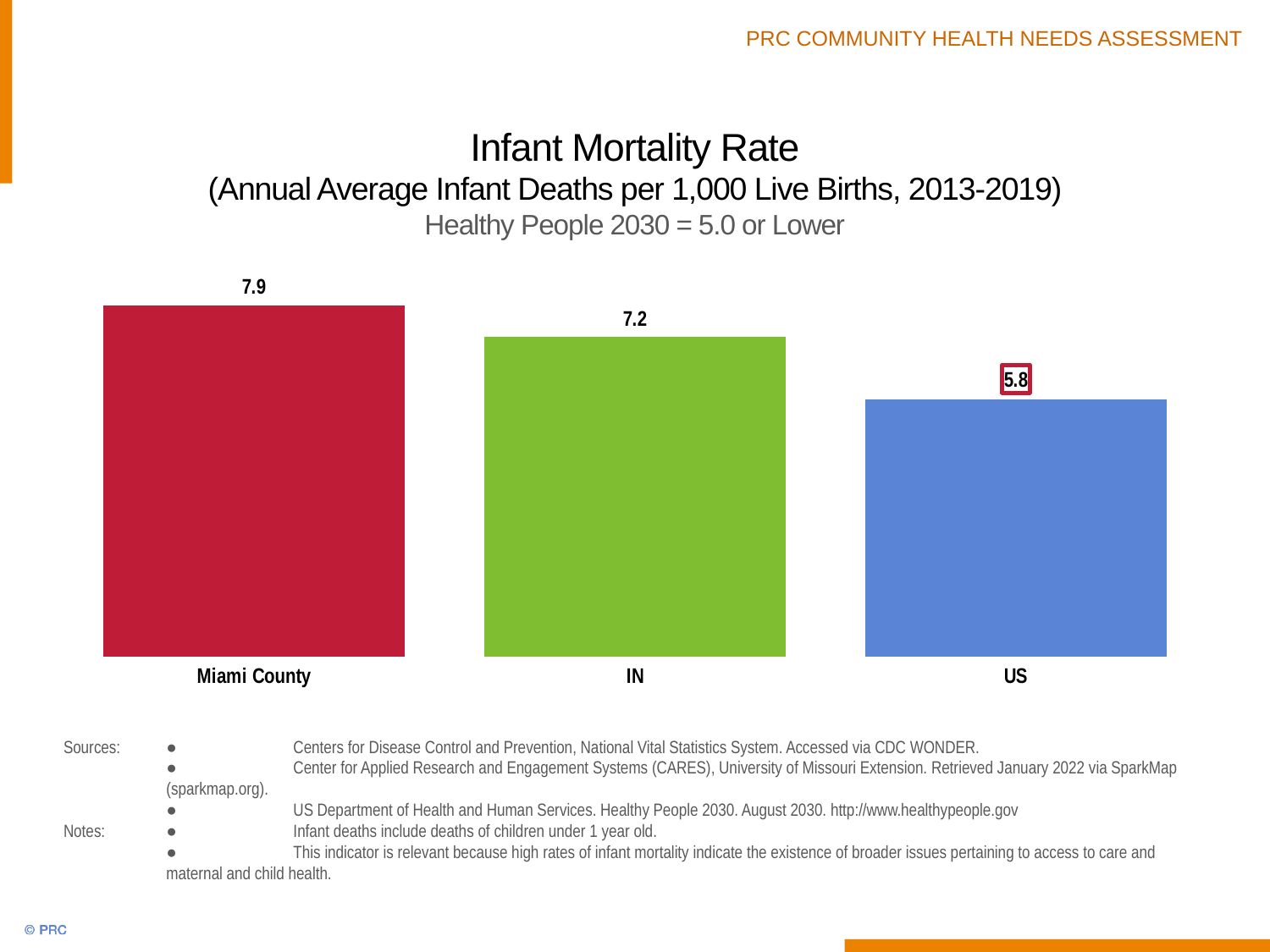
How many categories are shown in the chart? 3 What is the difference between the infant mortality rates for Miami County and IN? 0.7 Which category has the highest infant mortality rate? Miami County Do the values rise or fall from left to right across the chart? Fall Which has a higher infant mortality rate, IN or the US? IN What is the infant mortality rate for Miami County? 7.9 What is the infant mortality rate for IN? 7.2 What is the infant mortality rate for the US? 5.8 What kind of chart is shown on the slide? Bar chart What is the Healthy People 2030 target stated in the chart subtitle? 5.0 or Lower What is the difference between the infant mortality rates for Miami County and the US? 2.1 Which category has the lowest infant mortality rate? US